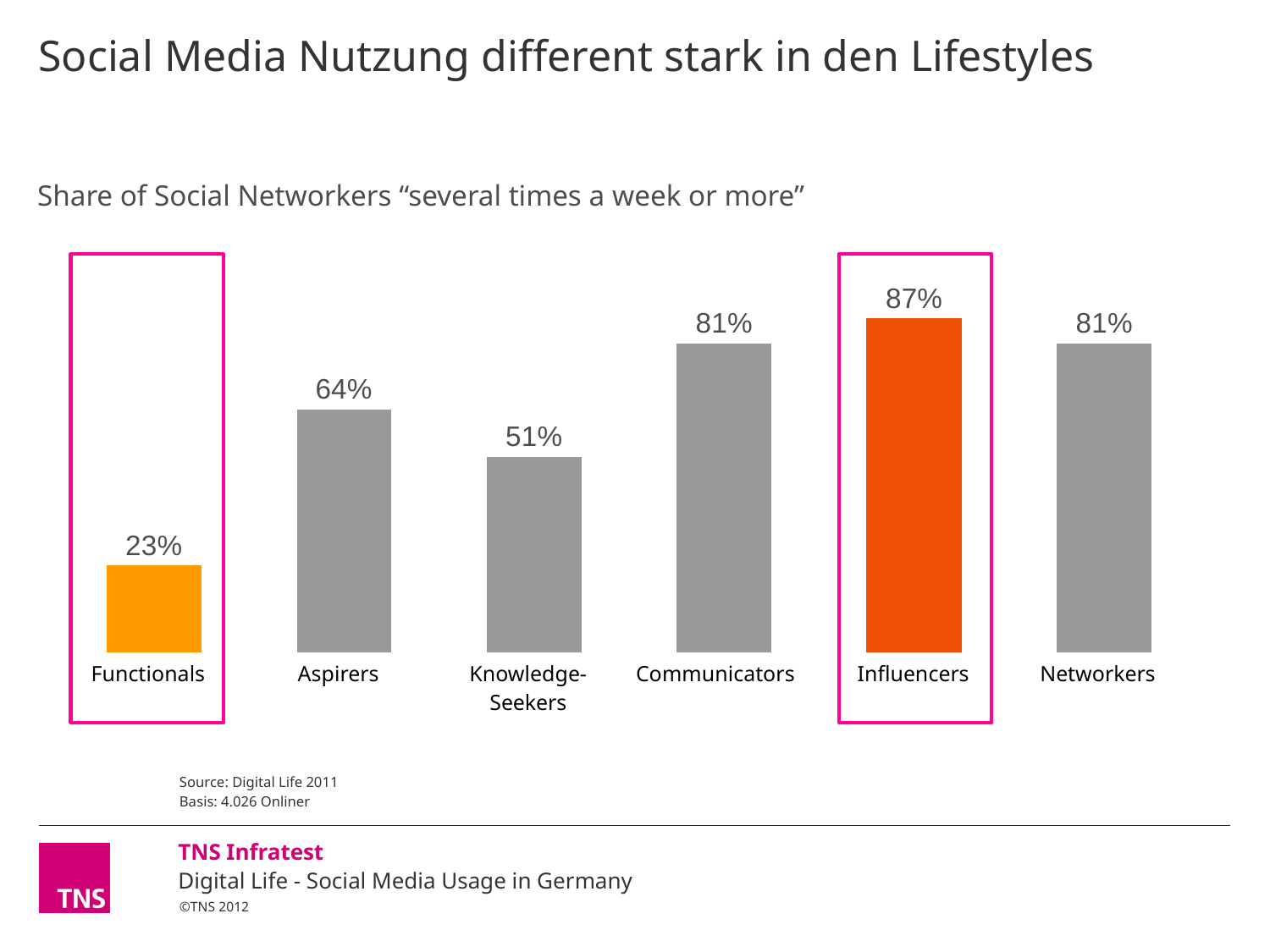
What kind of chart is shown on the slide? Bar chart What is the share of Social Networkers for Functionals? 23% What is the share of Social Networkers for Aspirers? 64% Which two lifestyle groups are highlighted with a pink outline box? Functionals and Influencers What is the difference between the shares for Influencers and Functionals? 64 percentage points What is the difference between the shares for Aspirers and Knowledge-Seekers? 13 percentage points Which lifestyle group has the lowest share of Social Networkers? Functionals Which lifestyle group has the highest share of Social Networkers? Influencers How many lifestyle groups are shown in the chart? 6 What is the share of Social Networkers for Knowledge-Seekers? 51% What is the share of Social Networkers for Influencers? 87% Which has a larger share of Social Networkers, Aspirers or Knowledge-Seekers? Aspirers